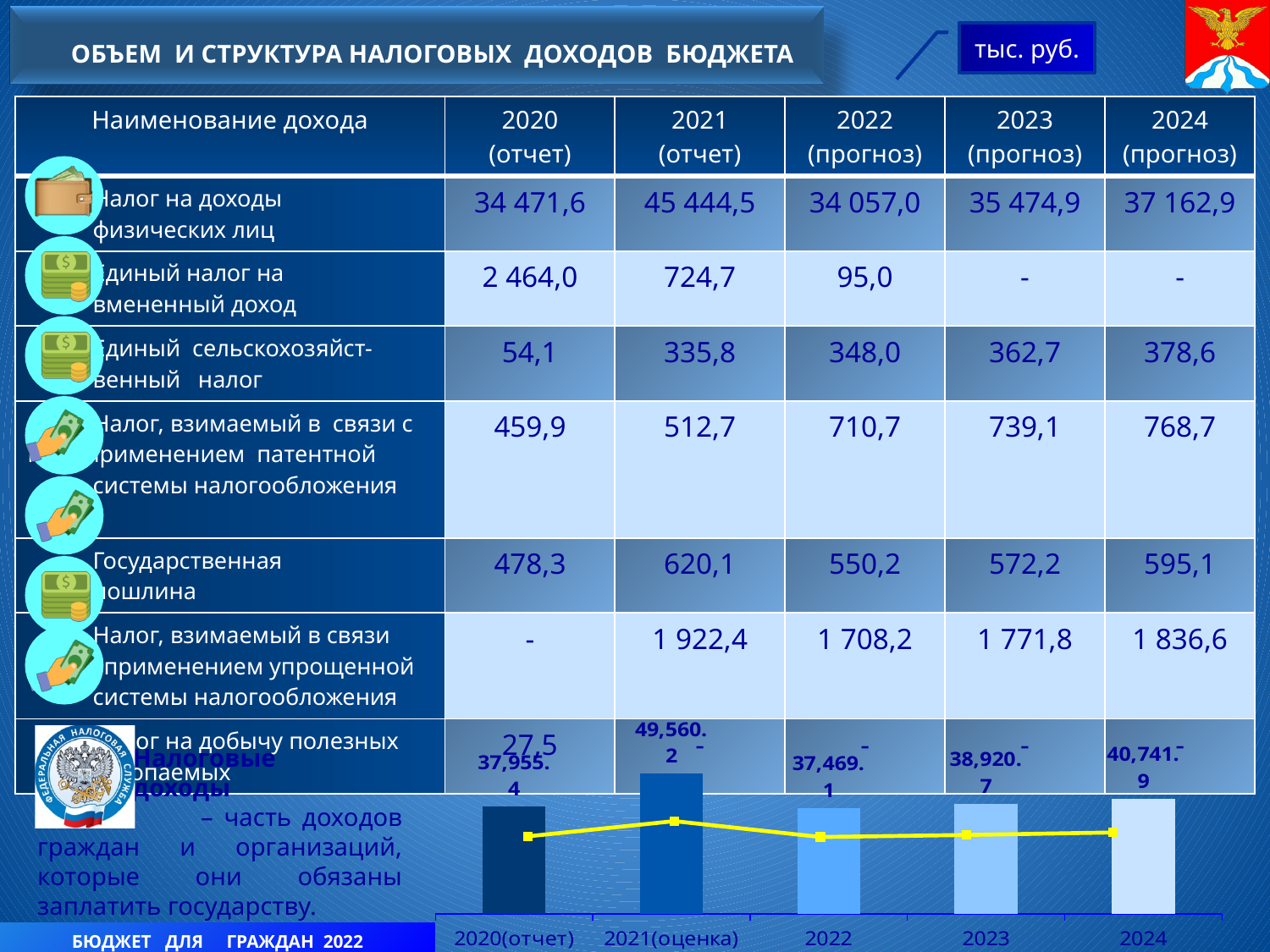
In the bar chart at the bottom of the slide, what is the value for 2024? 40,741.9 In the bar chart at the bottom of the slide, what is the value for 2023? 38,920.7 In the bar chart at the bottom of the slide, do the bar values rise or fall from 2022 to 2024? rise In the bar chart at the bottom of the slide, what is the value for 2021(оценка)? 49,560.2 In the bar chart at the bottom of the slide, what is the value for 2022? 37,469.1 In the bar chart at the bottom of the slide, which is larger, the value for 2023 or the value for 2022? 2023 In the bar chart at the bottom of the slide, which category has the lowest bar? 2022 In the bar chart at the bottom of the slide, what is the difference between the values for 2021(оценка) and 2020(отчет)? 11,604.8 In the bar chart at the bottom of the slide, what is the difference between the values for 2024 and 2023? 1,821.2 In the bar chart at the bottom of the slide, which category has the highest bar? 2021(оценка) In the bar chart at the bottom of the slide, what is the value for 2020(отчет)? 37,955.4 How many categories are shown on the x axis of the bar chart at the bottom of the slide? 5